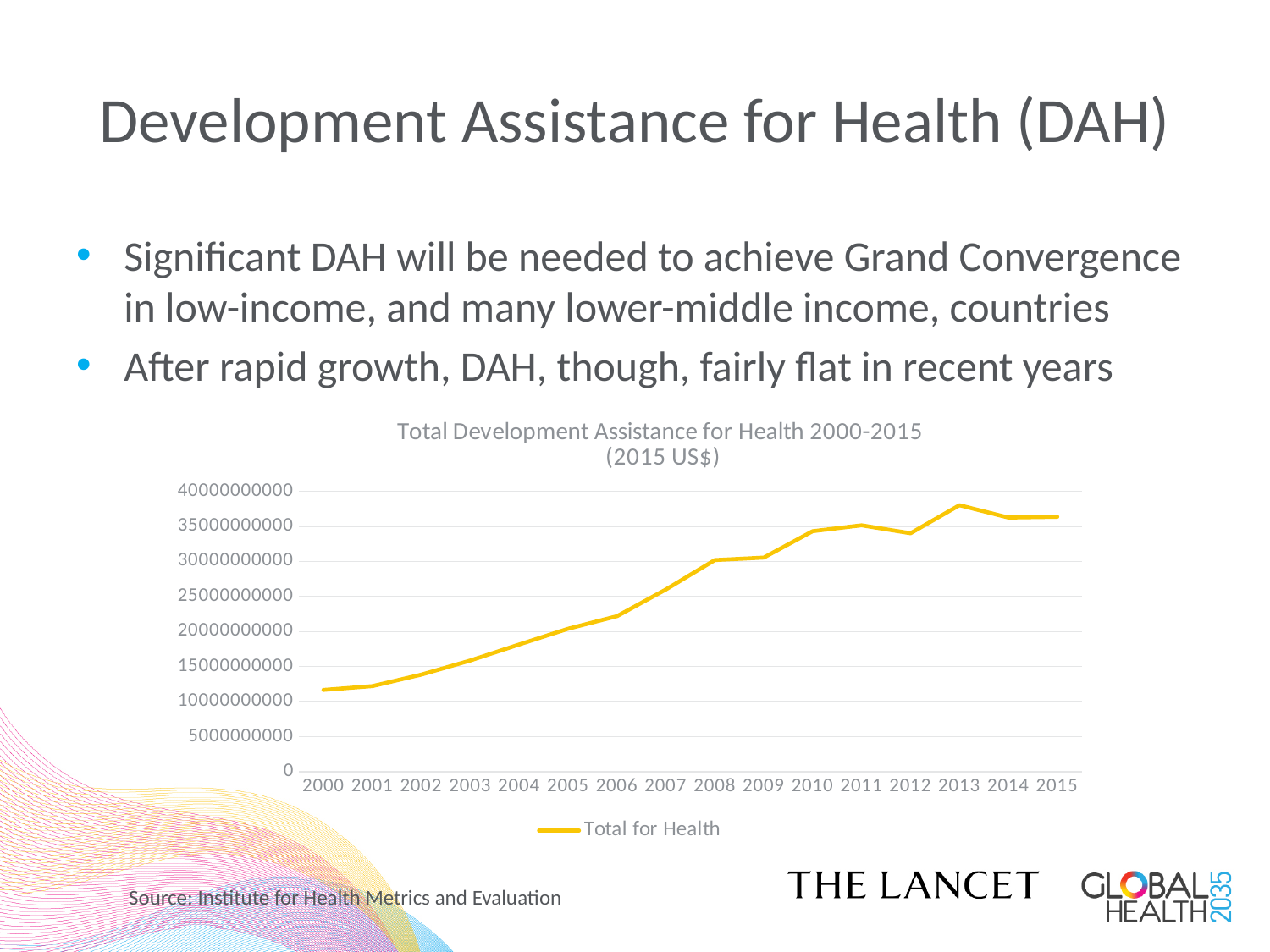
What is the title of the chart? Total Development Assistance for Health 2000-2015 (2015 US$) What kind of chart is shown on the slide? line chart How many years are plotted along the x axis? 16 What is the name of the series shown in the legend? Total for Health Is the value for 2006 greater or less than 25000000000? less Does Total for Health generally rise or fall from 2000 to 2015? rise In which year is Total for Health highest? 2013 Which year has the higher value for Total for Health, 2013 or 2015? 2013 Is the value for 2000 greater or less than 10000000000? greater How many series does the chart legend list? 1 In which year is Total for Health lowest? 2000 Is the value for 2013 greater or less than 35000000000? greater